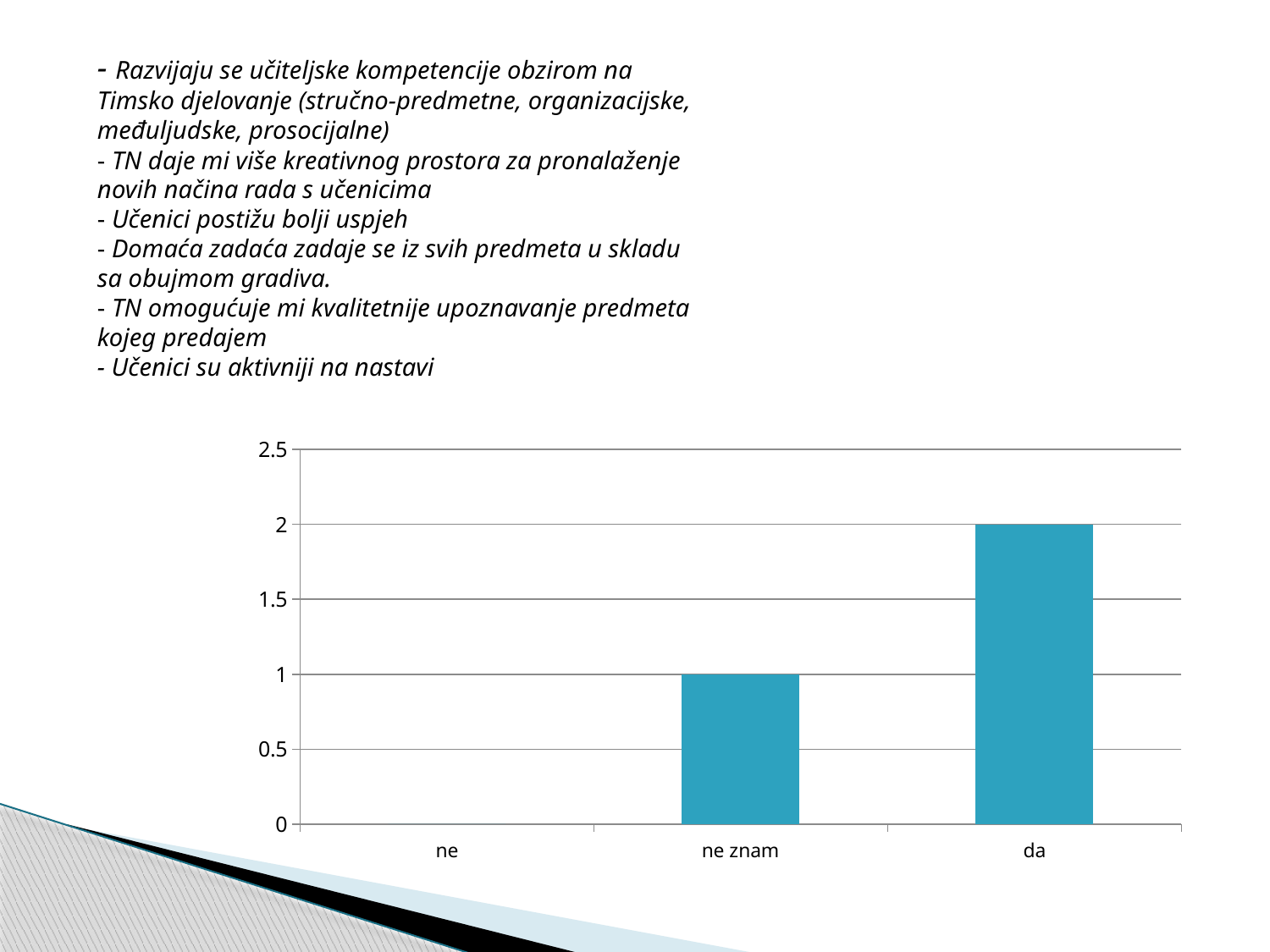
Which category has the lowest value in the chart? ne What is the highest value labelled on the vertical axis of the chart? 2.5 How many categories are shown on the x axis of the chart? 3 What kind of chart is shown on the slide? bar chart What is the difference between the values for "da" and "ne znam"? 1 What is the value for "ne znam" in the chart? 1 Which is larger, the value for "da" or the value for "ne znam"? da What is the value for "da" in the chart? 2 Which category has the highest value in the chart? da What is the value for "ne" in the chart? 0 Do the values rise or fall moving from left to right along the x axis? rise Is the value for "da" greater or less than 1.5? greater